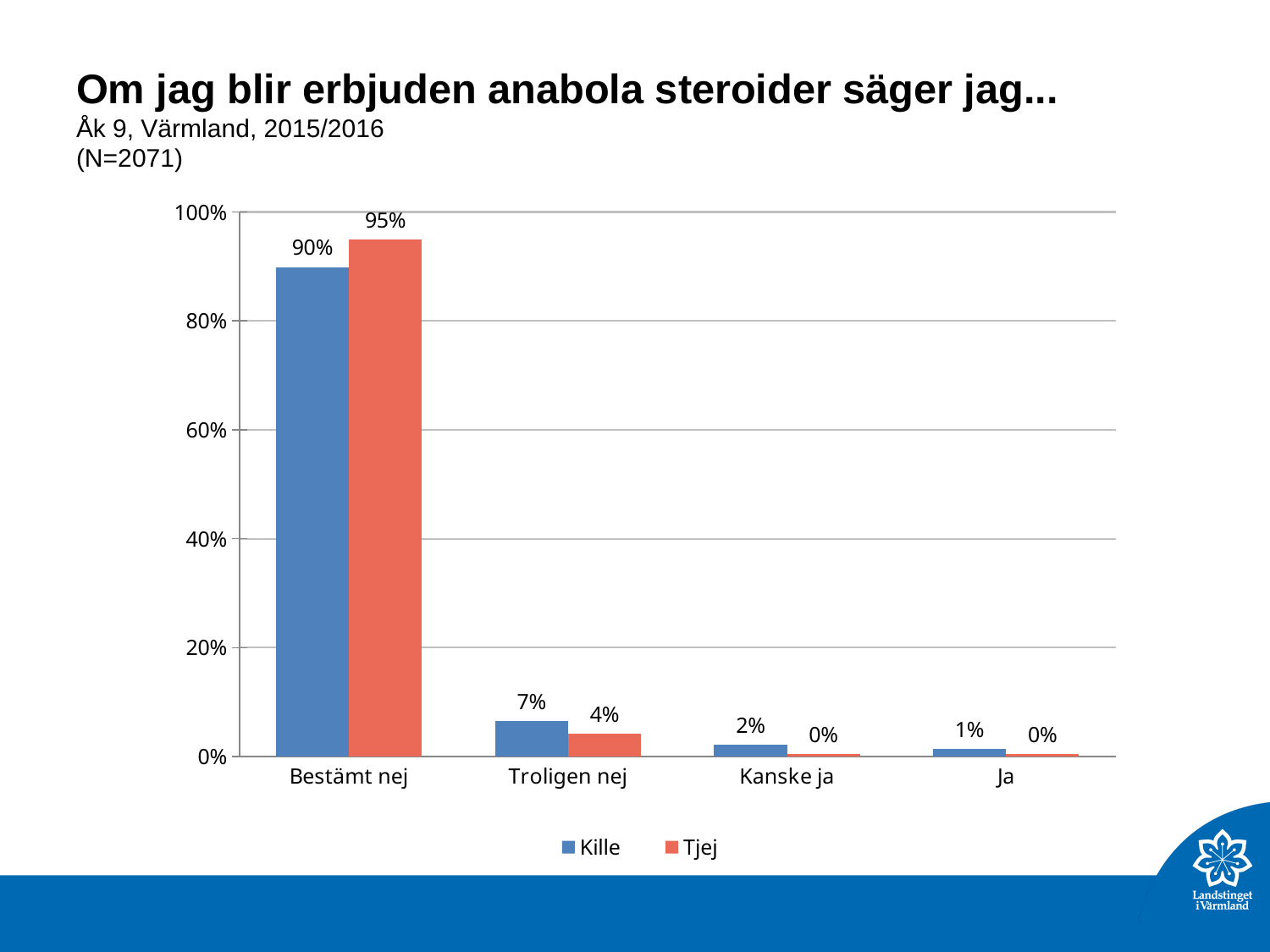
In the Troligen nej category, which series has the larger value, Kille or Tjej? Kille What kind of chart is shown on the slide? Bar chart How many categories are shown on the x axis? 4 Which category has the highest value for Tjej? Bestämt nej What is the difference between the Tjej and Kille values in the Bestämt nej category? 5% What is the value for Tjej in the Bestämt nej category? 95% Which category has the lowest value for Kille? Ja What is the value for Kille in the Troligen nej category? 7% What is the value for Kille in the Bestämt nej category? 90% How many series does the legend list? 2 Is the value for Kille in the Bestämt nej category greater or less than 80%? greater What is the value for Tjej in the Kanske ja category? 0%